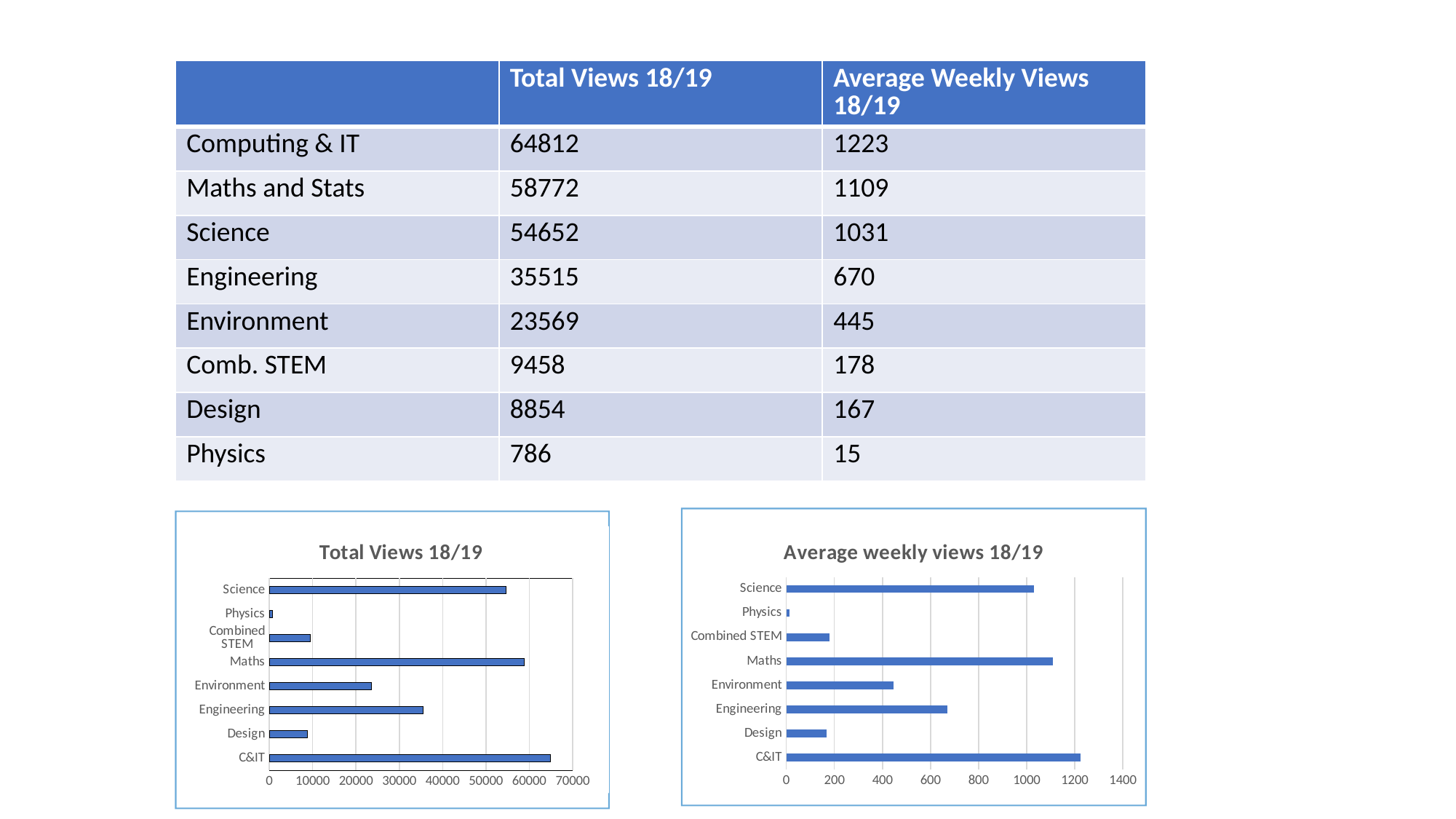
In the 'Total Views 18/19' chart, is the value for Engineering greater or less than 30000? greater In the 'Total Views 18/19' chart, which category has the lowest value? Physics In the 'Average weekly views 18/19' chart, which category has the highest value? C&IT In the 'Average weekly views 18/19' chart, is the value for Combined STEM greater or less than 200? less In the 'Total Views 18/19' chart, which category has the highest value? C&IT In the 'Total Views 18/19' chart, is the value for Design greater or less than 10000? less What is the title of the chart on the right of the slide? Average weekly views 18/19 In the 'Total Views 18/19' chart, which is larger, Engineering or Environment? Engineering What kind of chart is the 'Total Views 18/19' chart? bar chart In the 'Average weekly views 18/19' chart, which category has the lowest value? Physics How many categories are shown in the 'Total Views 18/19' chart? 8